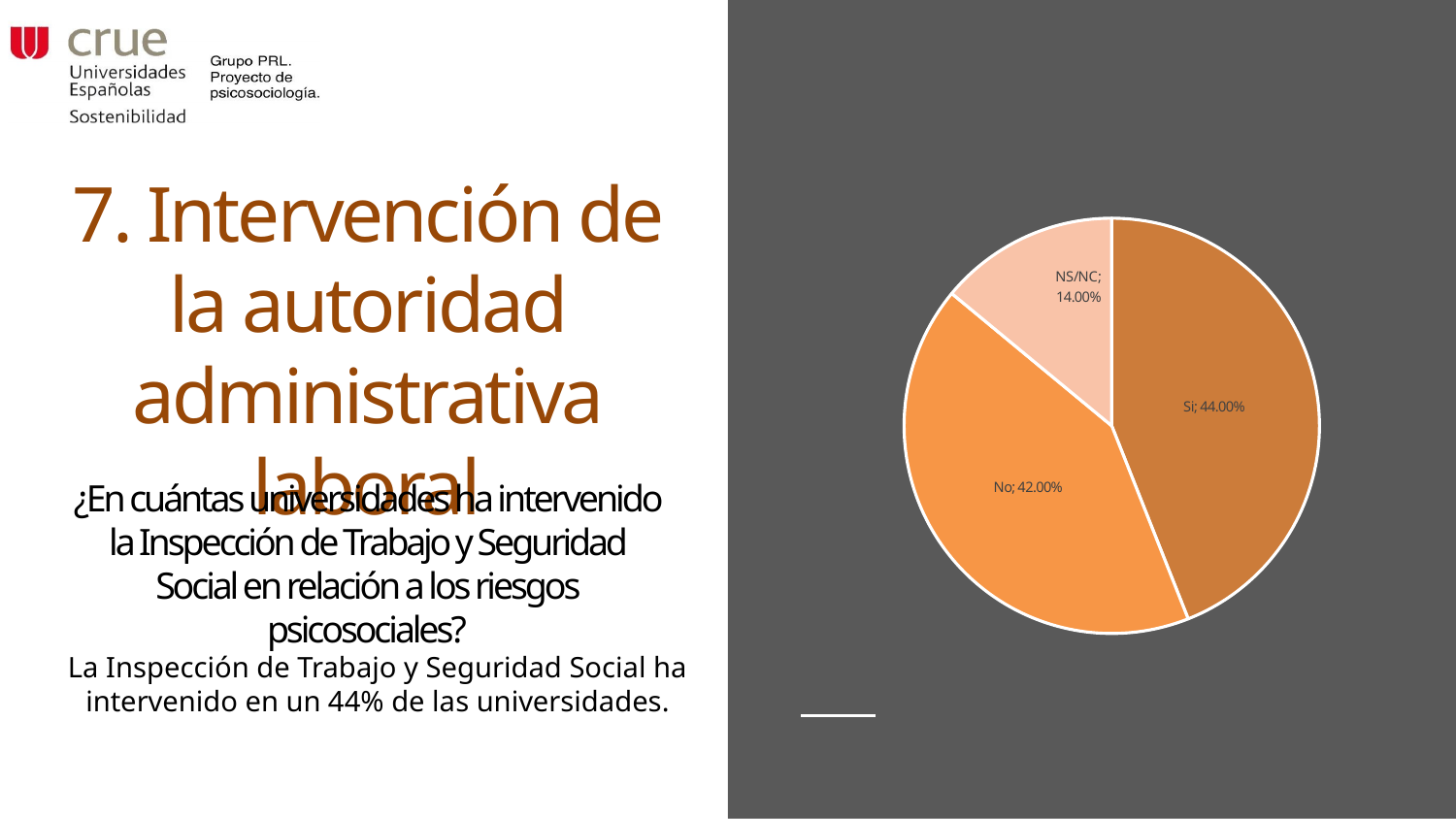
What is the value for the "Si" slice? 44.00% What kind of chart is shown on the slide? pie chart How many slices does the pie chart have? 3 What is the difference between the "No" and "NS/NC" slices? 28.00% Which slice has the smallest share? NS/NC Which slice has the largest share? Si Which is larger, the "No" slice or the "NS/NC" slice? No What is the difference between the "Si" and "No" slices? 2.00% Which slice is shown in the lightest colour? NS/NC What is the value for the "No" slice? 42.00% What share of the pie does the "NS/NC" slice represent? 14.00% What is the value for the "NS/NC" slice? 14.00%